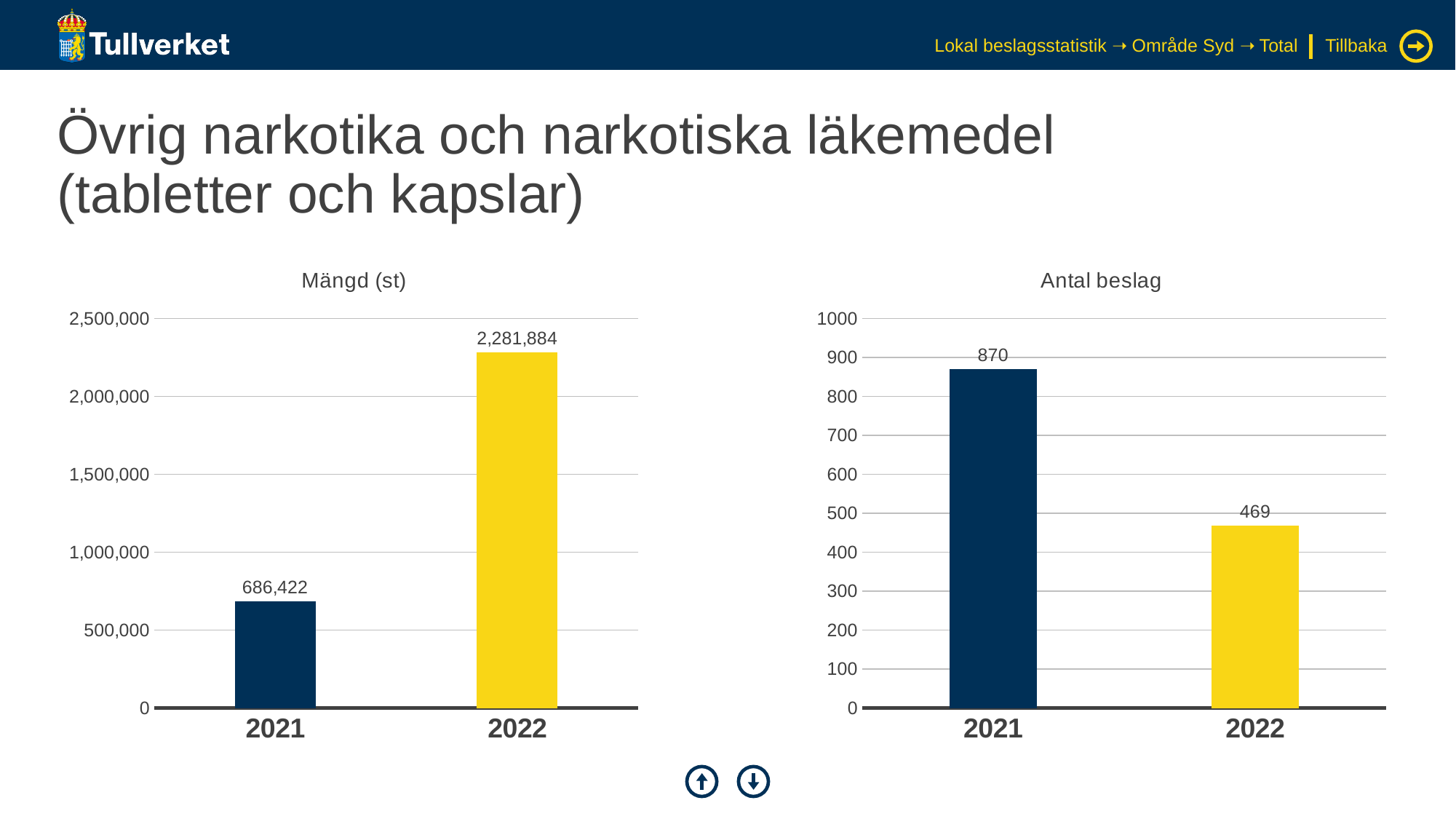
In the "Mängd (st)" chart, what is the value for 2022? 2,281,884 In the "Antal beslag" chart, is the value for 2021 greater or less than 800? greater In the "Mängd (st)" chart, what is the difference between the 2022 and 2021 values? 1,595,462 In the "Mängd (st)" chart, do the values rise or fall from 2021 to 2022? rise In the "Antal beslag" chart, what is the value for 2022? 469 How many categories are shown in the "Antal beslag" chart? 2 In the "Antal beslag" chart, which year has the lowest value? 2022 What kind of chart is the "Mängd (st)" chart? bar chart In the "Antal beslag" chart, what is the value for 2021? 870 In the "Mängd (st)" chart, what is the value for 2021? 686,422 In the "Mängd (st)" chart, which year has the highest value? 2022 In the "Antal beslag" chart, what is the difference between the 2021 and 2022 values? 401